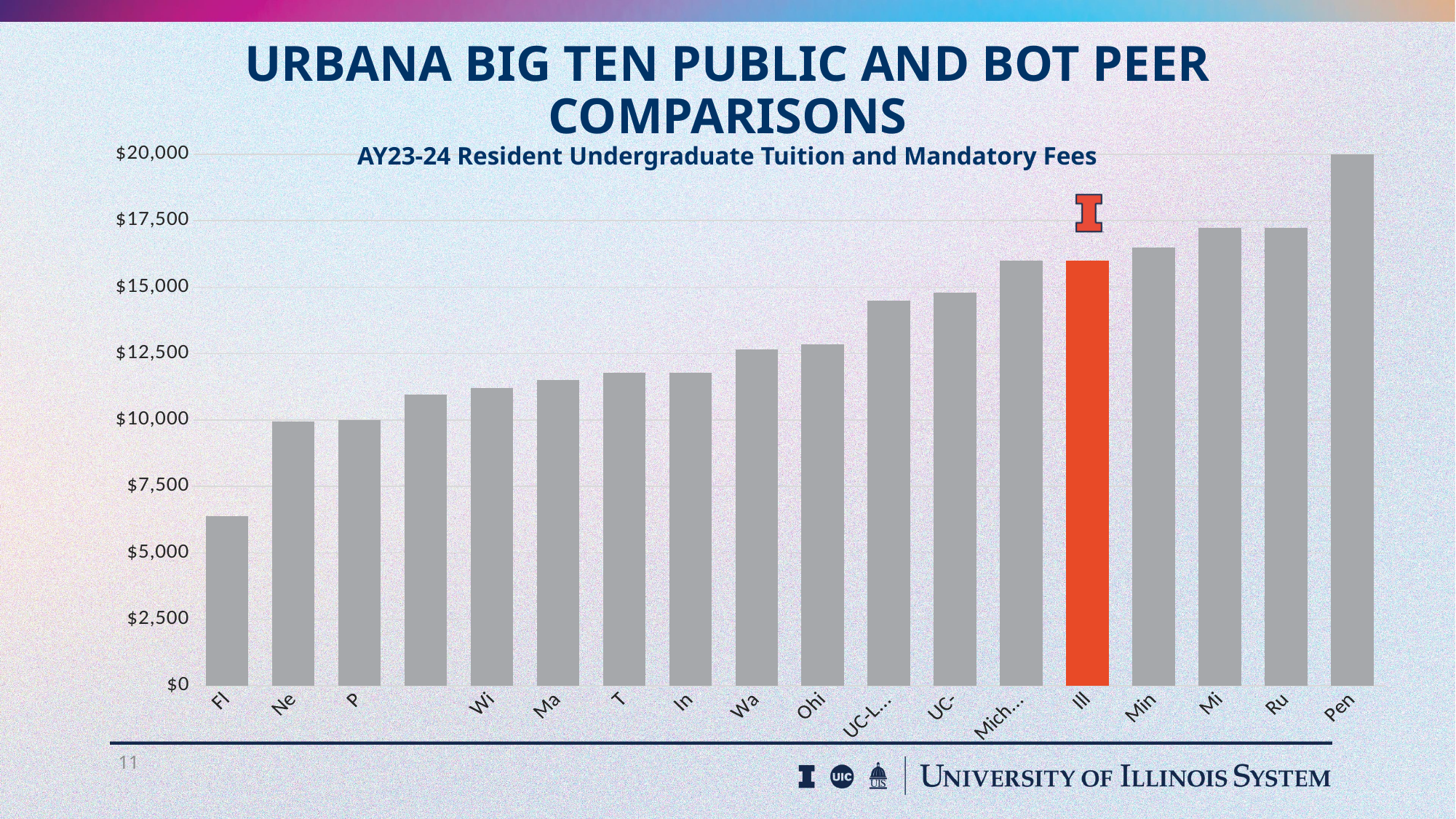
Which category has the highest value? Pen Which is larger, the value for Wi or the value for Ill? Ill Is the value for Pen greater or less than $17,500? greater Which is larger, the value for Ru or the value for Ma? Ru Is the value for Ill greater or less than $15,000? greater Is the value for Ne greater or less than $12,500? less Which category has the lowest value? Fl What kind of chart is shown on the slide? bar chart Do the values generally rise or fall from left to right along the x axis? rise Which category's bar is highlighted in orange? Ill